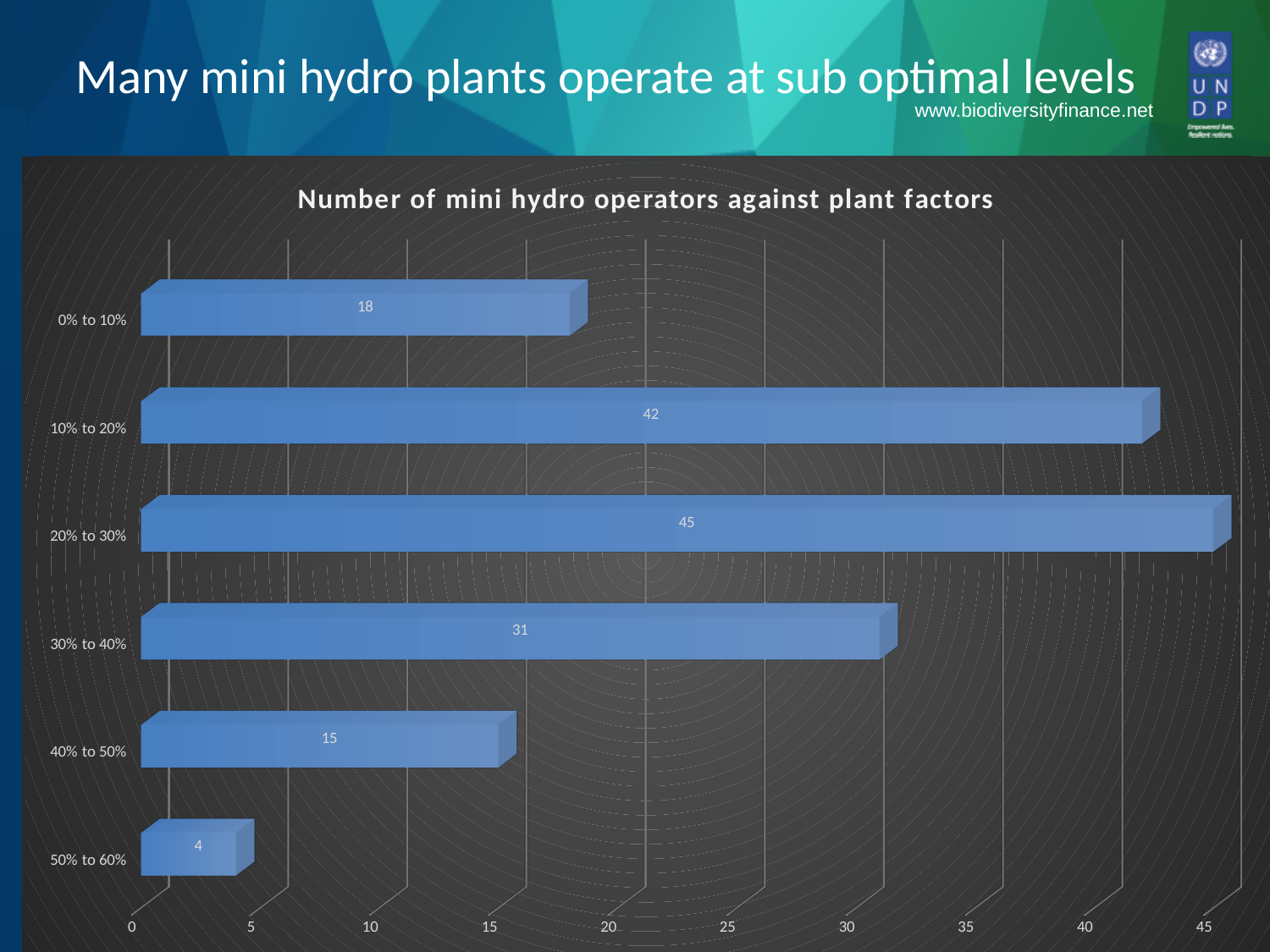
What is the number of mini hydro operators with a plant factor of 30% to 40%? 31 What is the title of the chart? Number of mini hydro operators against plant factors What is the number of mini hydro operators with a plant factor of 50% to 60%? 4 Which plant factor category has the highest number of mini hydro operators? 20% to 30% What kind of chart is shown on the slide? Bar chart Is the value for the 10% to 20% category greater or less than 40? greater Which plant factor category has the lowest number of mini hydro operators? 50% to 60% What is the difference between the number of operators in the 30% to 40% category and the 40% to 50% category? 16 What is the number of mini hydro operators with a plant factor of 0% to 10%? 18 How many plant factor categories are shown in the chart? 6 What is the difference between the number of operators in the 20% to 30% category and the 10% to 20% category? 3 Which category has more operators: 0% to 10% or 40% to 50%? 0% to 10%